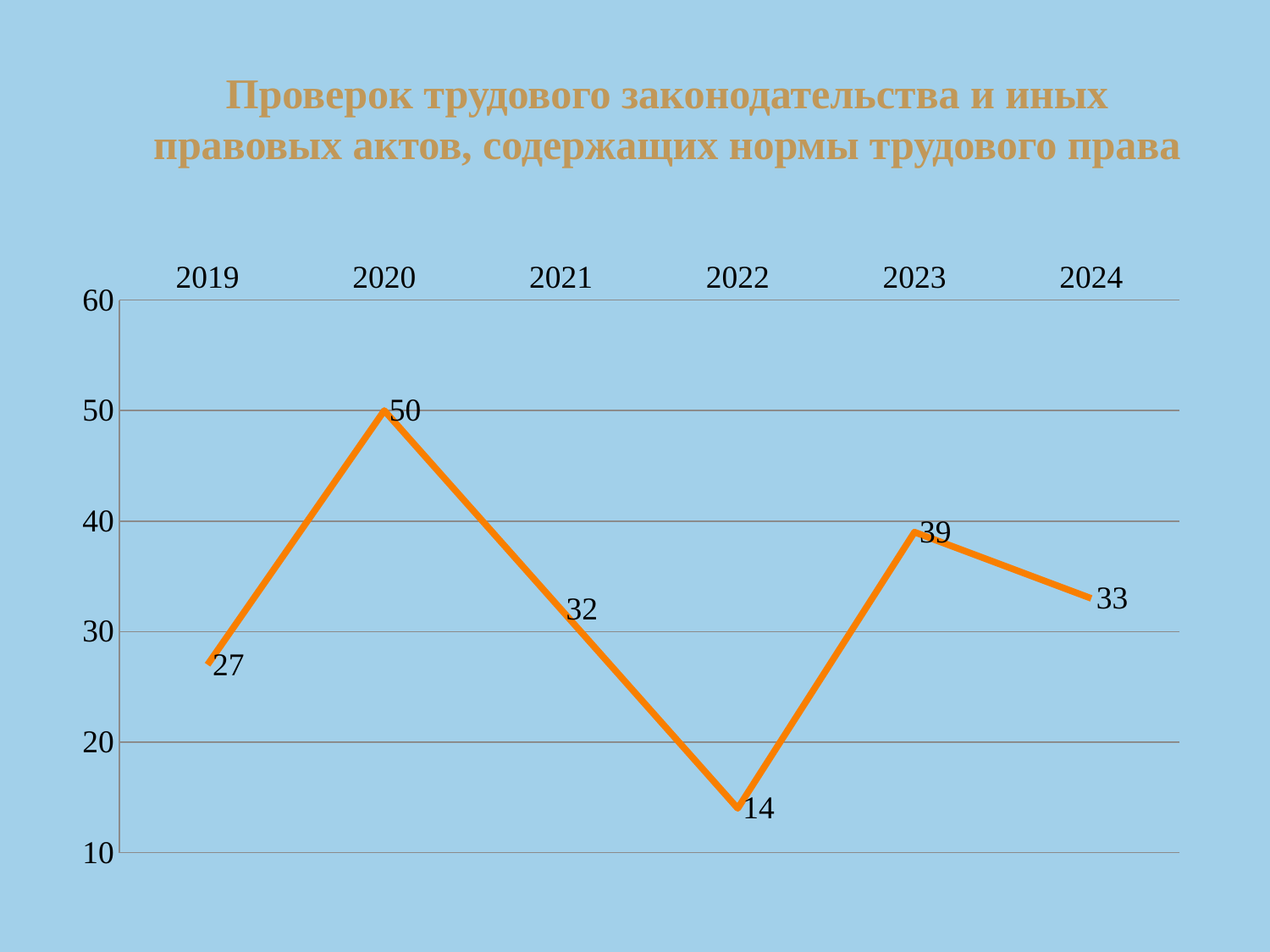
What is the value for 2022? 14 Which year has the lowest value? 2022 Which is larger, the value for 2019 or the value for 2021? 2021 Does the value rise or fall from 2023 to 2024? fall How many years are plotted on the chart? 6 What is the value for 2020? 50 What is the difference between the values for 2020 and 2022? 36 What is the difference between the values for 2023 and 2024? 6 Is the value for 2023 greater or less than 30? greater What kind of chart is shown on the slide? line chart Which year has the highest value? 2020 What is the value for 2024? 33